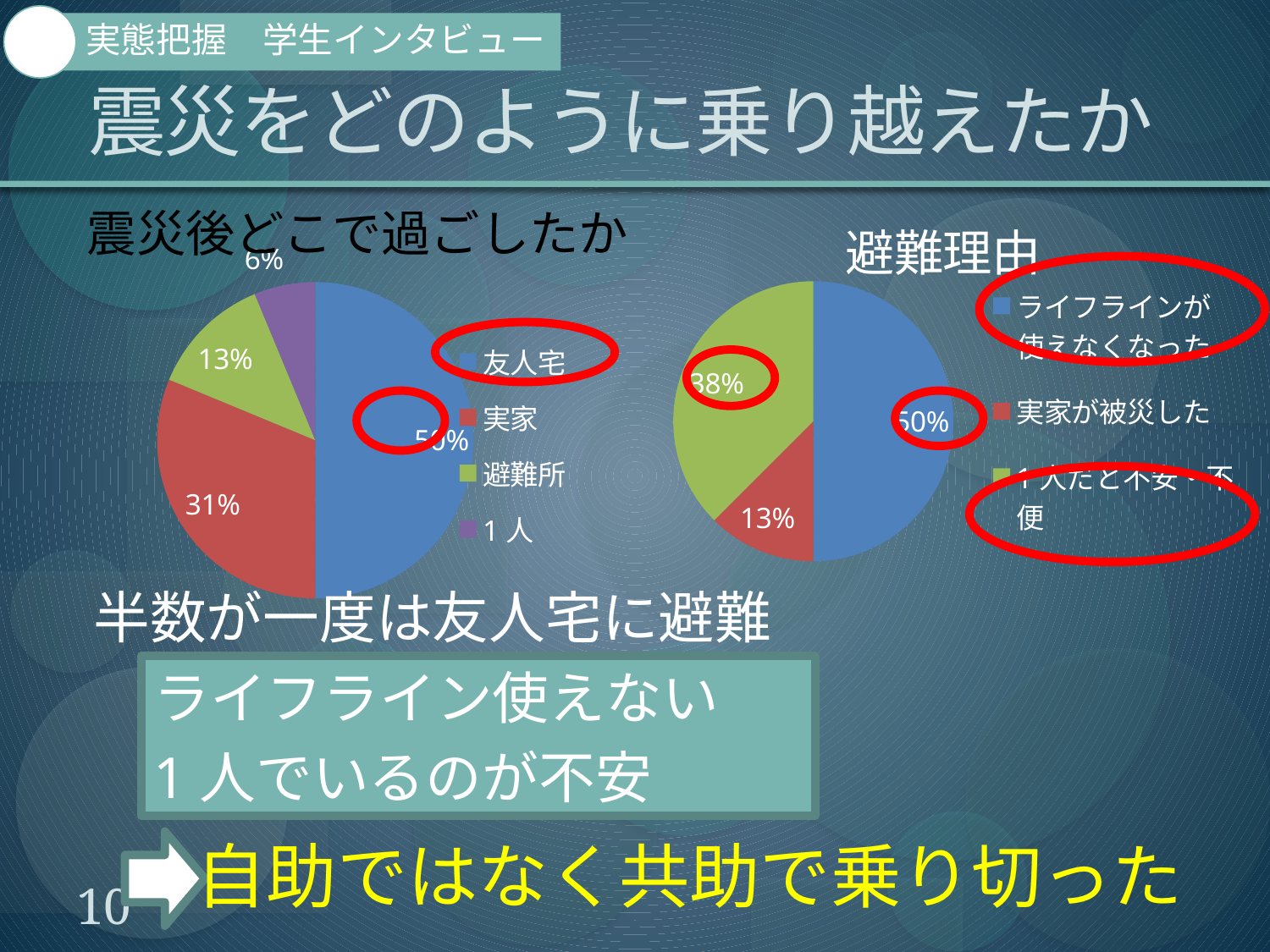
In the 避難理由 chart, which is larger, 実家が被災した or 1人だと不安・不便? 1人だと不安・不便 In the 避難理由 chart, what share is ライフラインが使えなくなった? 50% In the 震災後どこで過ごしたか chart, what is the difference between 実家 and 避難所? 18% In the 避難理由 chart, how many categories does the legend list? 3 In the 震災後どこで過ごしたか chart, which category has the smallest share? 1人 In the 震災後どこで過ごしたか chart, what share is 友人宅? 50% What type of chart is used for 震災後どこで過ごしたか? pie chart In the 震災後どこで過ごしたか chart, what share is 避難所? 13% In the 避難理由 chart, which category has the largest share? ライフラインが使えなくなった In the 震災後どこで過ごしたか chart, what share is 実家? 31% In the 震災後どこで過ごしたか chart, how many categories are shown? 4 In the 避難理由 chart, what share is 実家が被災した? 13%